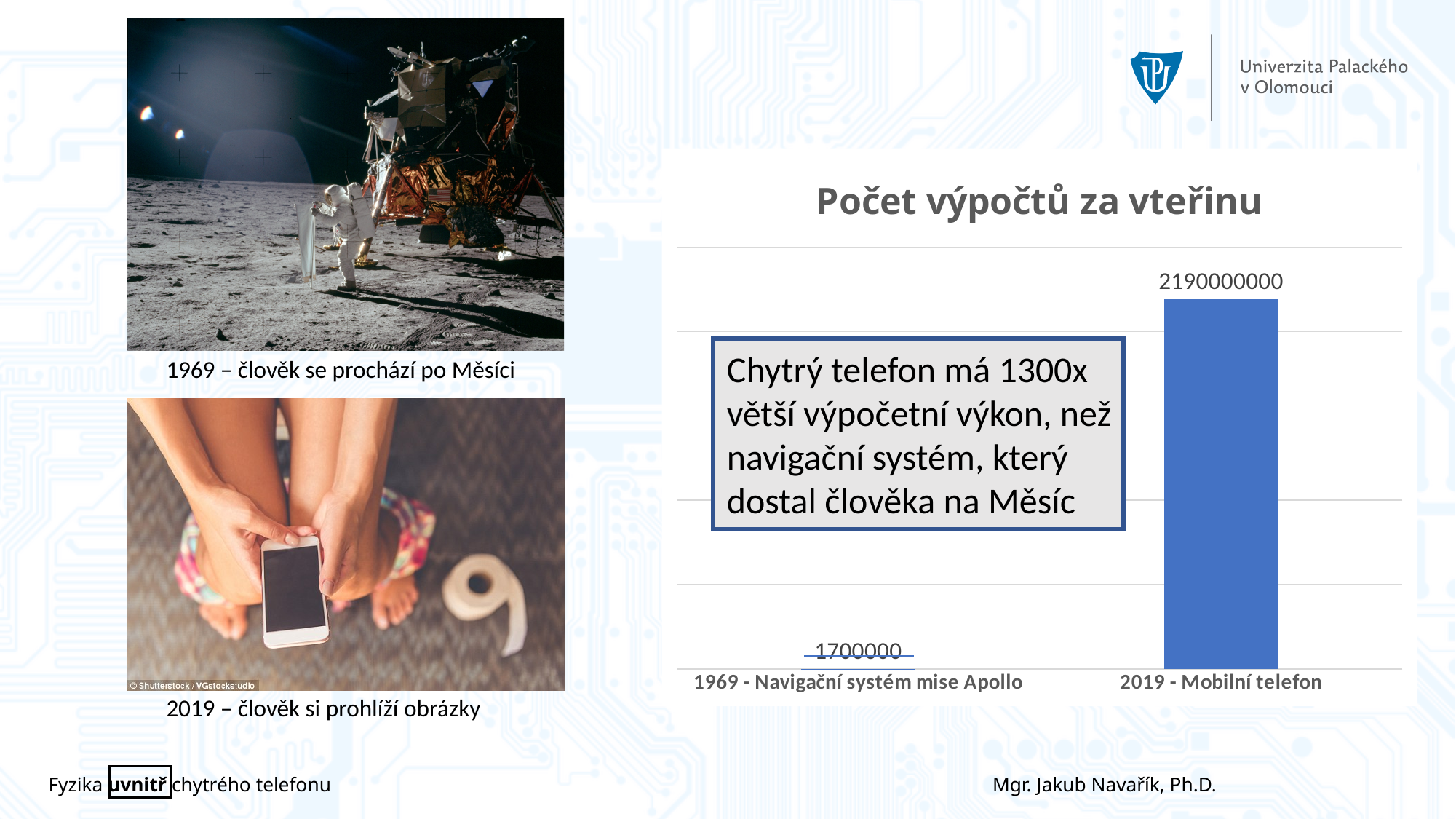
What colour are the bars in the chart? Blue How many categories are shown in the chart? 2 What is the value for "2019 - Mobilní telefon" in the chart? 2190000000 What kind of chart is shown on the slide? Bar chart What is the difference between the value for "2019 - Mobilní telefon" and the value for "1969 - Navigační systém mise Apollo"? 2188300000 Which category has the highest value in the chart? 2019 - Mobilní telefon Do the values rise or fall from left to right along the x axis of the chart? Rise What is the value for "1969 - Navigační systém mise Apollo" in the chart? 1700000 What is the title of the chart? Počet výpočtů za vteřinu Which category has the lowest value in the chart? 1969 - Navigační systém mise Apollo Which is larger: the value for "1969 - Navigační systém mise Apollo" or the value for "2019 - Mobilní telefon"? 2019 - Mobilní telefon